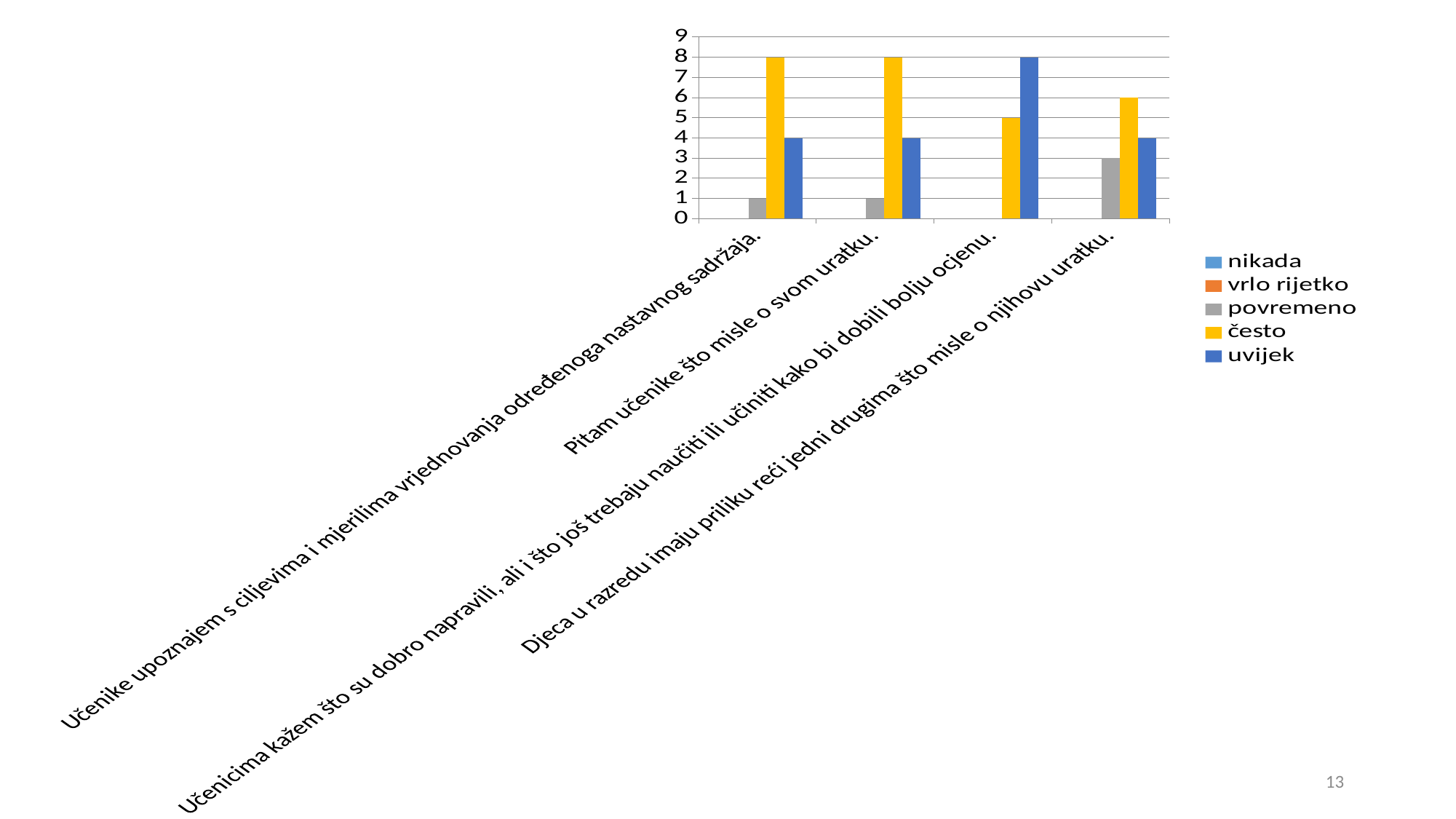
What kind of chart is shown on the slide? bar chart What is the value of the 'često' series for 'Djeca u razredu imaju priliku reći jedni drugima što misle o njihovu uratku.'? 6 How many categories are shown on the x axis? 4 Which legend entry is shown in yellow? često For which category is the 'često' series lowest? Učenicima kažem što su dobro napravili, ali i što još trebaju naučiti ili učiniti kako bi dobili bolju ocjenu. For 'Učenicima kažem što su dobro napravili, ali i što još trebaju naučiti ili učiniti kako bi dobili bolju ocjenu.', which is larger: 'često' or 'uvijek'? uvijek What is the value of the 'uvijek' series for 'Učenicima kažem što su dobro napravili, ali i što još trebaju naučiti ili učiniti kako bi dobili bolju ocjenu.'? 8 For which category is the 'uvijek' series highest? Učenicima kažem što su dobro napravili, ali i što još trebaju naučiti ili učiniti kako bi dobili bolju ocjenu. How many series does the legend list? 5 What is the value of the 'povremeno' series for 'Djeca u razredu imaju priliku reći jedni drugima što misle o njihovu uratku.'? 3 What is the difference between the 'često' and 'uvijek' values for 'Učenike upoznajem s ciljevima i mjerilima vrjednovanja određenoga nastavnog sadržaja.'? 4 What is the value of the 'često' series for 'Pitam učenike što misle o svom uratku.'? 8